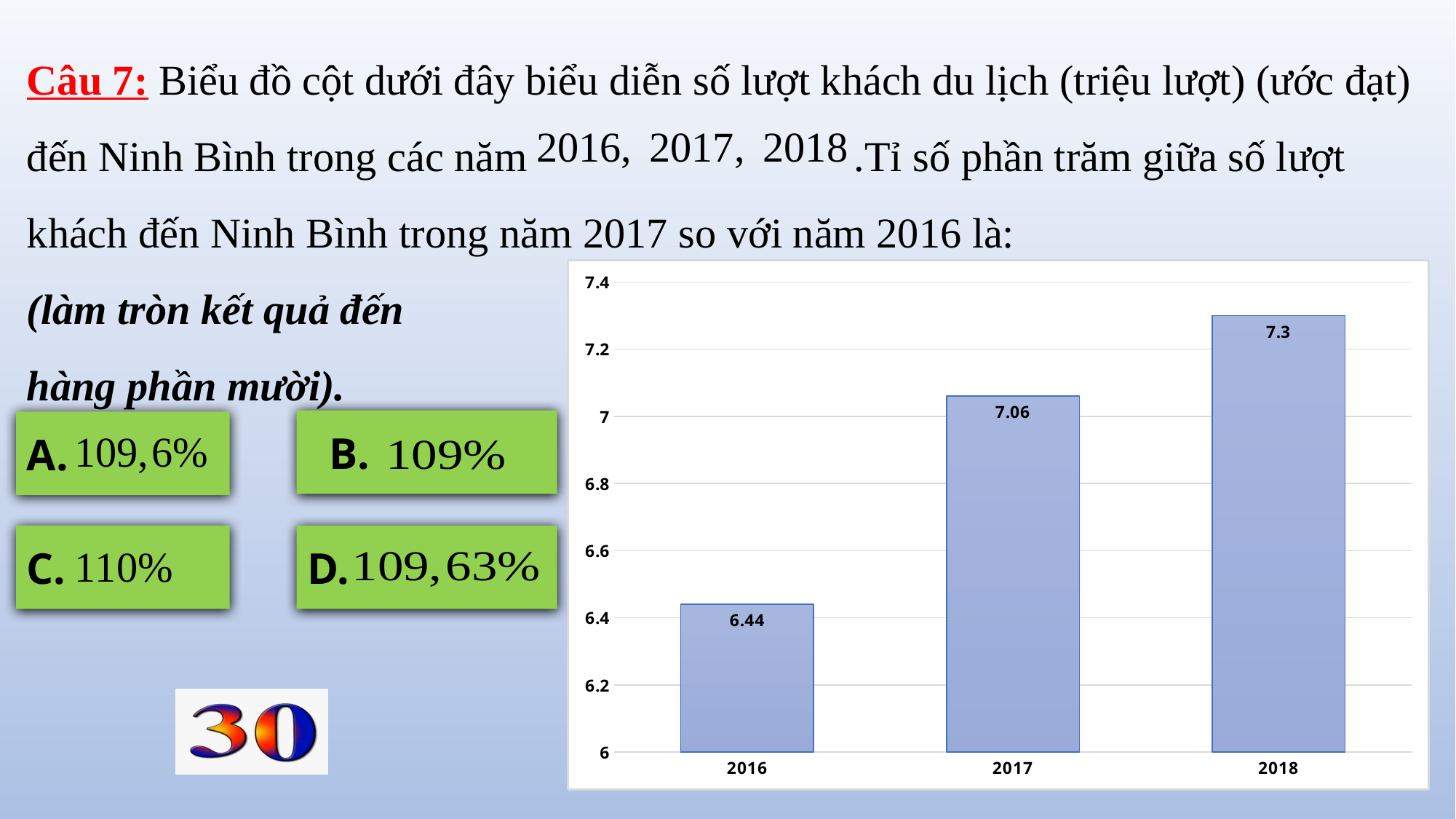
Do the values rise or fall from 2016 to 2018? rise Is the value for 2016 greater or less than 6.6? less What is the value for 2017? 7.06 Which year has the highest value? 2018 What is the value for 2016? 6.44 Which year has the lowest value? 2016 How many years are shown on the x axis? 3 What kind of chart is shown? bar chart Which is larger, the value for 2017 or the value for 2018? 2018 What is the value for 2018? 7.3 What is the difference between the values for 2017 and 2016? 0.62 What is the difference between the values for 2018 and 2017? 0.24